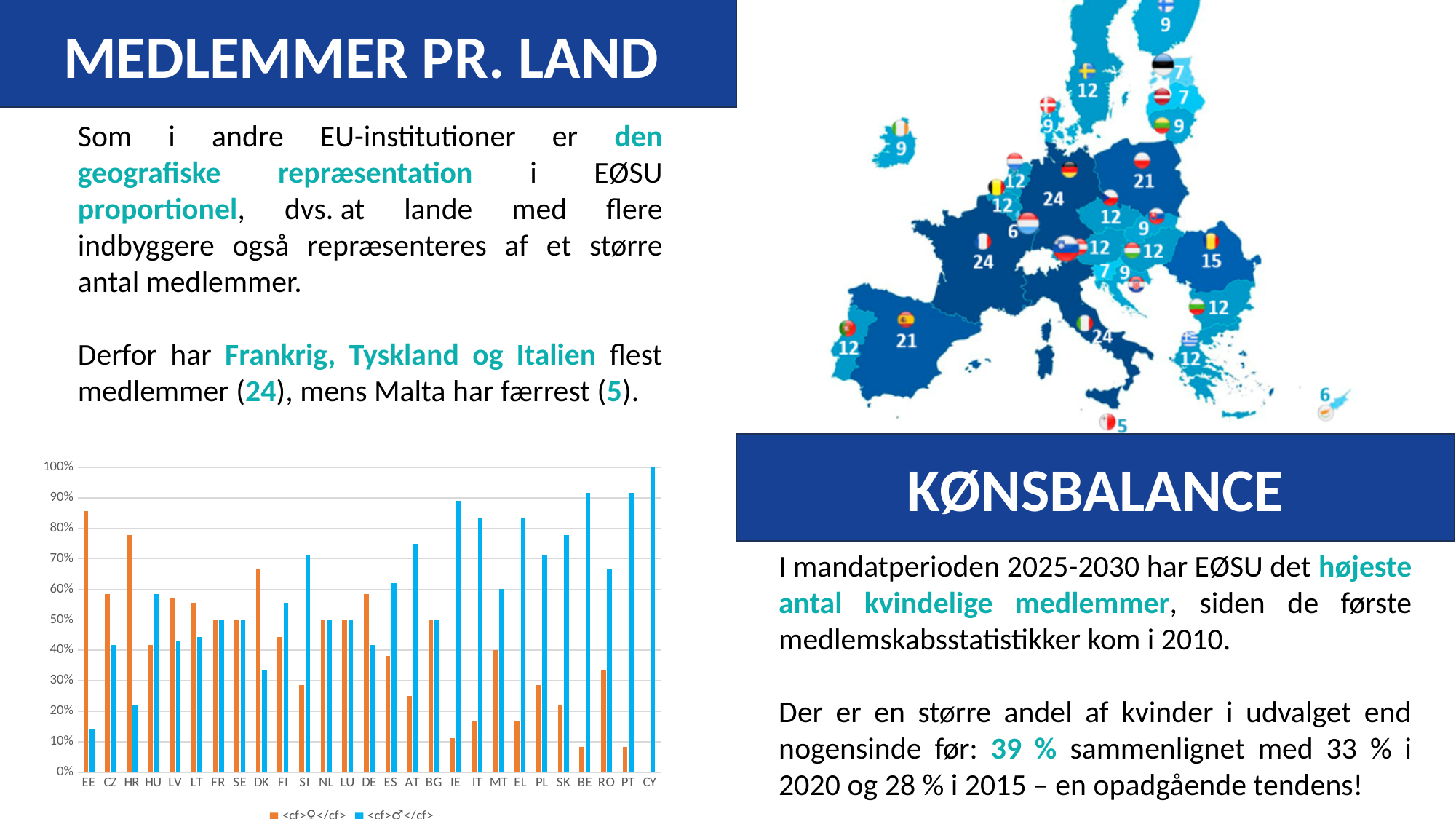
In the bar chart, is the orange (female) value for IE greater or less than 20%? less In the bar chart, what is the value of the orange (female) bar for FR? 50% In the bar chart, what is the value of the blue (male) bar for NL? 50% In the bar chart, which country has the highest value for the blue (male) series? CY In the bar chart, which is larger for HR: the orange (female) bar or the blue (male) bar? the orange (female) bar In the bar chart, is the orange (female) value for EE greater or less than 80%? greater How many countries are shown on the x axis of the bar chart? 27 In the bar chart, which is larger for IT: the orange (female) bar or the blue (male) bar? the blue (male) bar How many series does the legend of the bar chart list? 2 What kind of chart is shown at the bottom left of the slide? bar chart In the bar chart, is the blue (male) value for IE greater or less than 80%? greater In the bar chart, what is the value of the blue (male) bar for CY? 100%